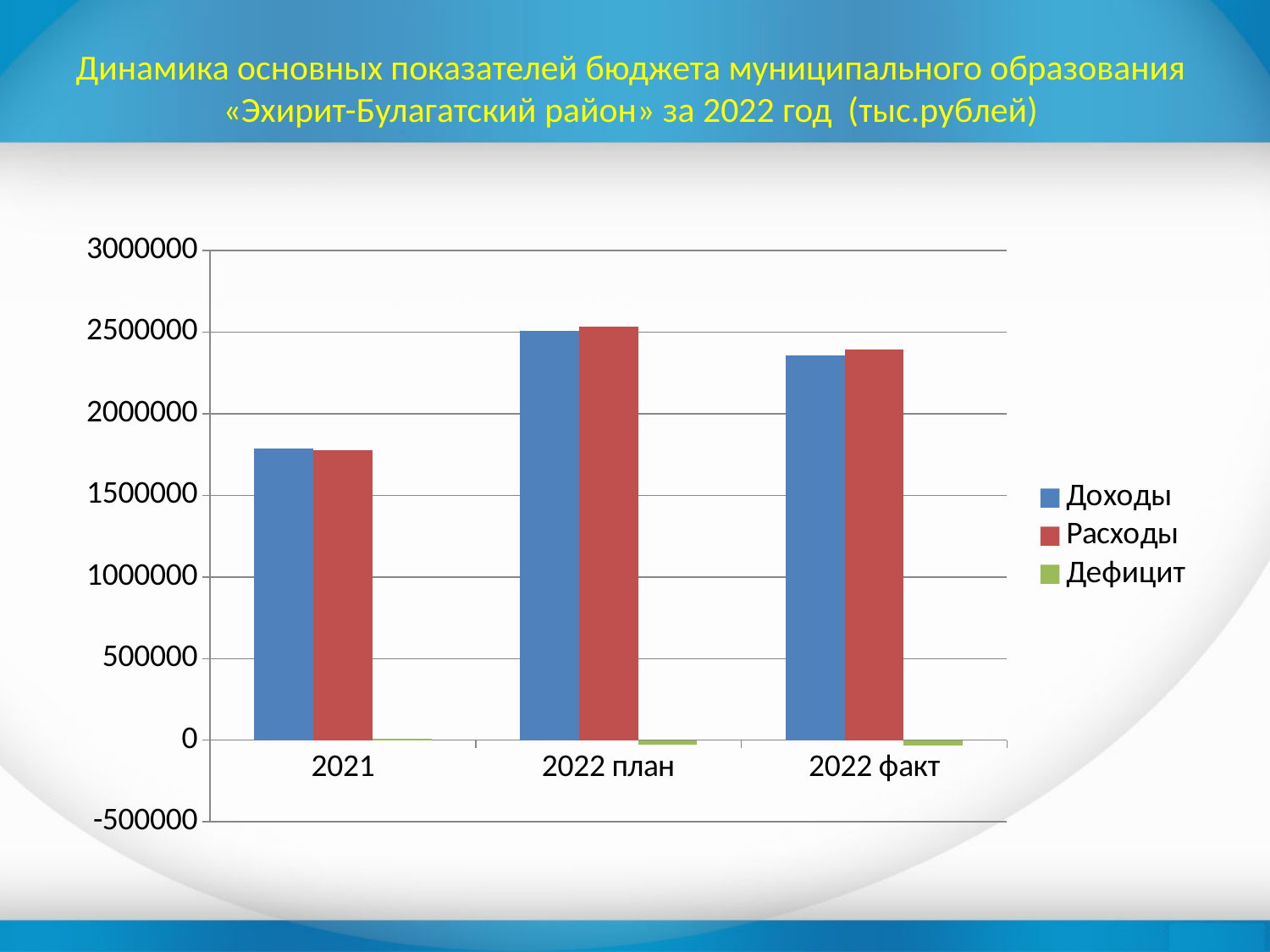
Which is larger: Доходы for 2022 план or Доходы for 2022 факт? 2022 план Is the value for Доходы in 2022 факт greater or less than 2500000? less Which category has the highest value for Доходы? 2022 план Is the value for Расходы in 2022 план greater or less than 2500000? greater What kind of chart is shown on the slide? Bar chart Does the value for Расходы rise or fall from 2021 to 2022 план? Rise How many series does the legend list? 3 Which category has the lowest value for Расходы? 2021 Which series is shown in green in the legend? Дефицит Is the value for Доходы in 2021 greater or less than 2000000? less How many categories are shown on the x axis? 3 What unit is stated in the chart title? тыс.рублей